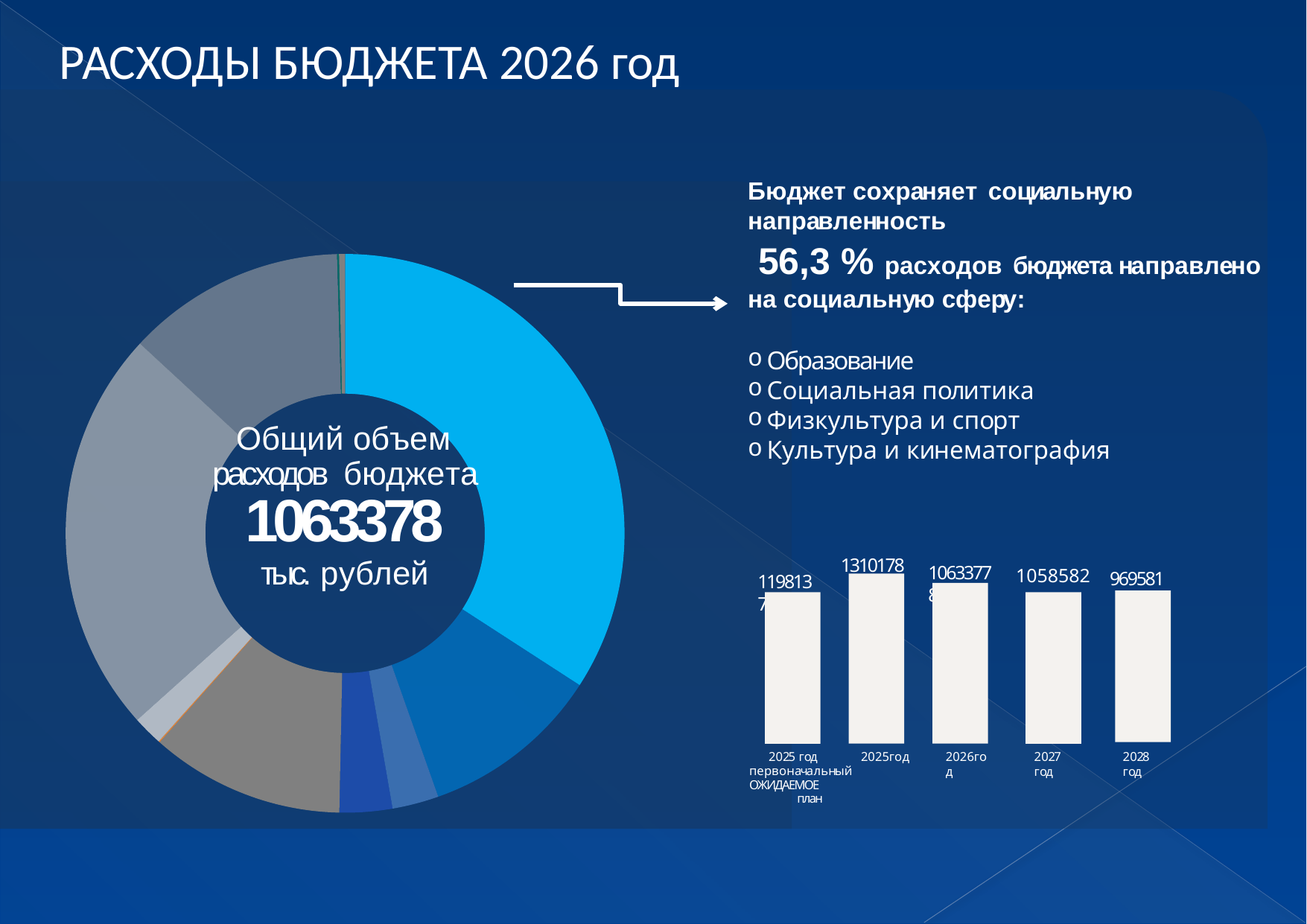
In the bar chart, what is the difference between the second bar (1310178) and the 2027 год bar (1058582)? 251596 What total value is printed in the centre of the donut chart? 1063378 тыс. рублей How many bars are in the bar chart? 5 In the bar chart, what is the value for 2027 год? 1058582 In the bar chart, what is the value for 2028 год? 969581 In the bar chart, what is the value of the second bar (2025 год ожидаемое)? 1310178 In the bar chart, which year has the lowest value? 2028 год In the bar chart, which bar has the highest value? 2025 год (ожидаемое), 1310178 In the bar chart, what is the difference between the values for 2027 год and 2028 год? 89001 In the bar chart, which is larger: the value for 2027 год or 2028 год? 2027 год What type of chart is shown on the right side of the slide? bar chart What type of chart is shown on the left side of the slide? donut chart